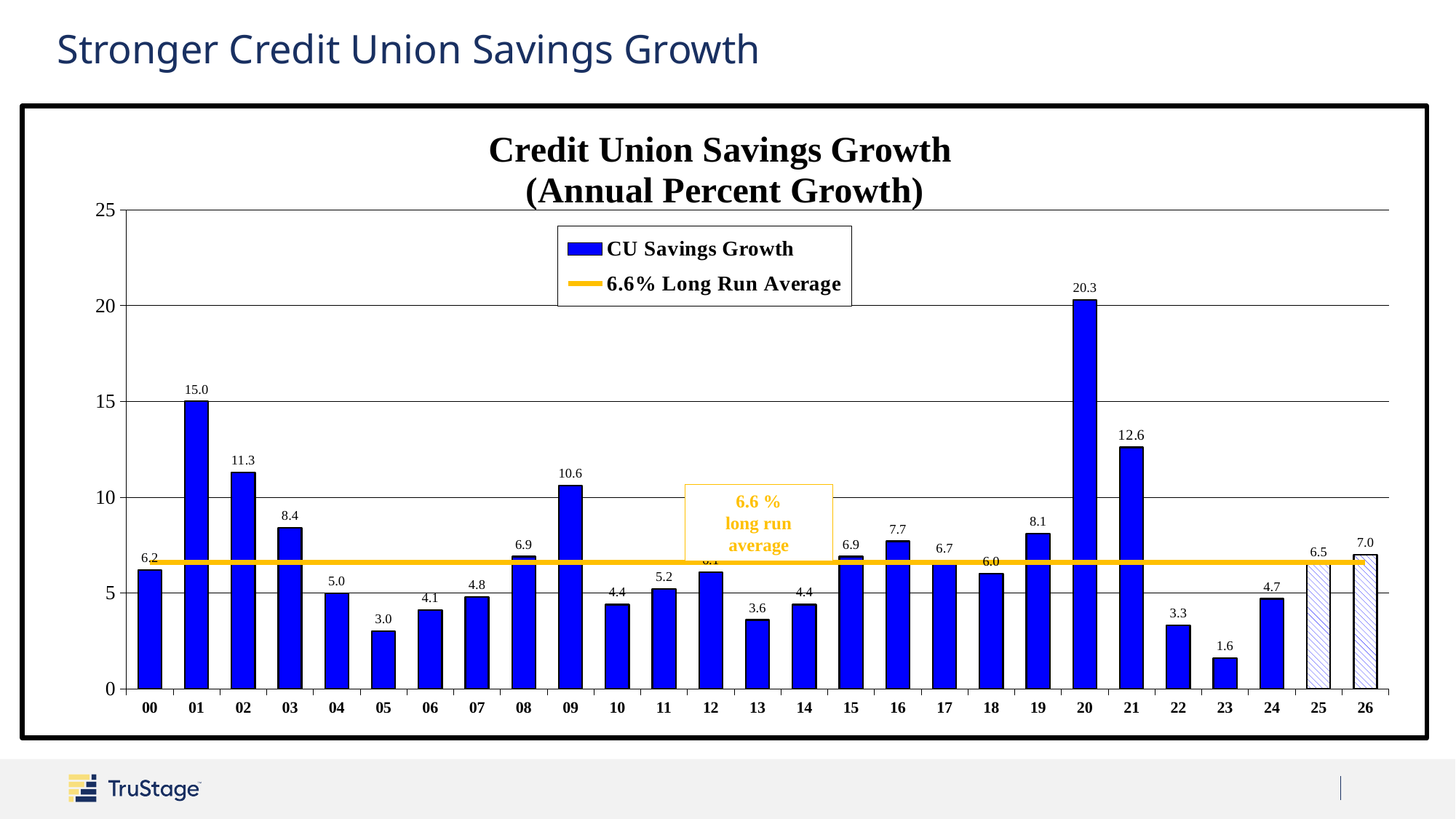
What kind of chart is shown? bar chart What is the CU Savings Growth value for 23? 1.6 What value does the yellow horizontal line represent? 6.6% Long Run Average What is the CU Savings Growth value for 09? 10.6 Is the CU Savings Growth value for 21 greater or less than 10? greater What is the difference between the CU Savings Growth values for 01 and 02? 3.7 How many series does the legend list? 2 Which year has the lowest CU Savings Growth? 23 How many years are shown on the x axis? 27 What is the CU Savings Growth value for 20? 20.3 Which is larger, the CU Savings Growth value for 16 or for 19? 19 Which year has the highest CU Savings Growth? 20